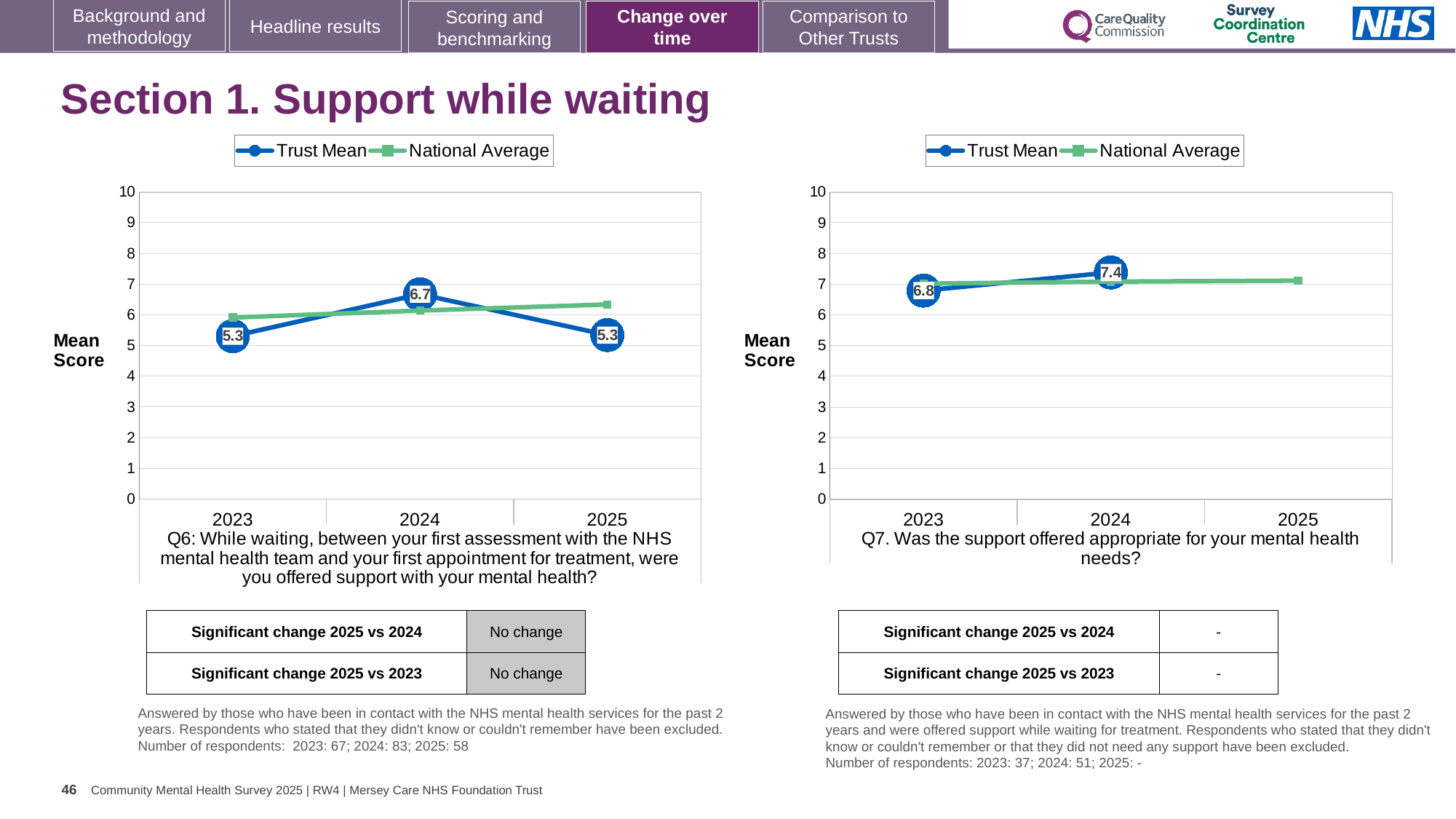
How many series does the legend of the Q7 chart on the right list? 2 In the Q7 chart on the right, what is the Trust Mean for 2024? 7.4 In the Q6 chart on the left, what is the difference between the Trust Mean for 2024 and the Trust Mean for 2023? 1.4 In the Q6 chart on the left, what is the Trust Mean for 2024? 6.7 In the Q6 chart on the left, what is the Trust Mean for 2025? 5.3 In the Q6 chart on the left, which year has the highest Trust Mean? 2024 In the Q6 chart on the left, is the Trust Mean for 2023 larger or smaller than the Trust Mean for 2024? smaller What kind of chart is the Q6 chart on the left? Line chart In the Q7 chart on the right, what is the difference between the Trust Mean for 2024 and the Trust Mean for 2023? 0.6 In the Q6 chart on the left, is the National Average for 2025 greater or less than 5? greater In the Q7 chart on the right, does the Trust Mean rise or fall from 2023 to 2024? rise In the Q7 chart on the right, what is the Trust Mean for 2023? 6.8